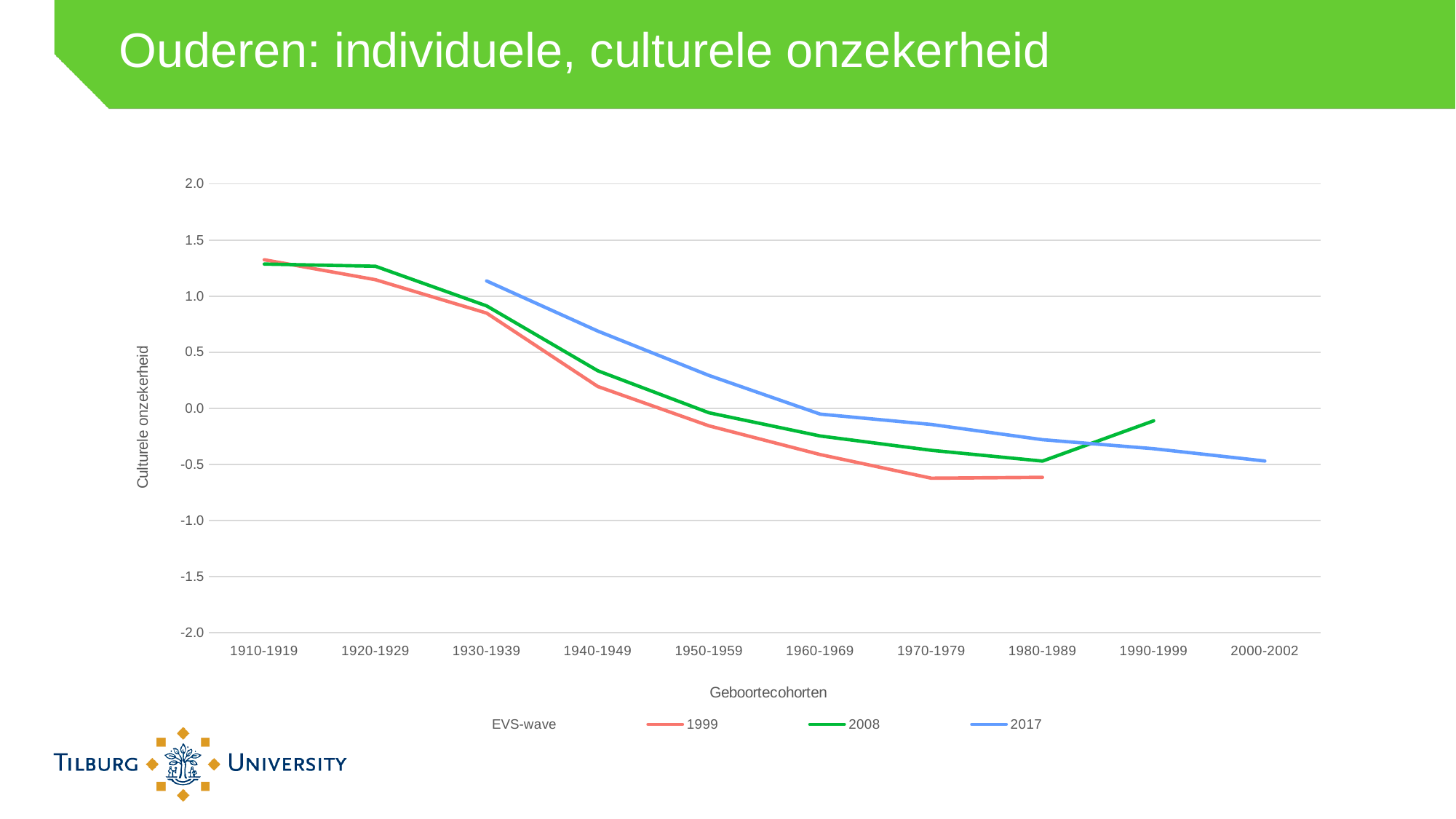
What is the title of the y axis? Culturele onzekerheid How many birth cohort categories are shown on the x axis? 10 Is the value for the 2017 series at 2000-2002 greater or less than 0.0? less At 1940-1949, which series has the higher value: 2008 or 2017? 2017 Is the value for the 2017 series at 1930-1939 greater or less than 1.0? greater Does the 1999 series rise or fall from 1910-1919 to 1970-1979? fall What kind of chart is shown on the slide? line chart Is the value for the 2008 series at 1940-1949 greater or less than 0.5? less What is the title of the x axis? Geboortecohorten At 1950-1959, which series has the higher value: 1999 or 2017? 2017